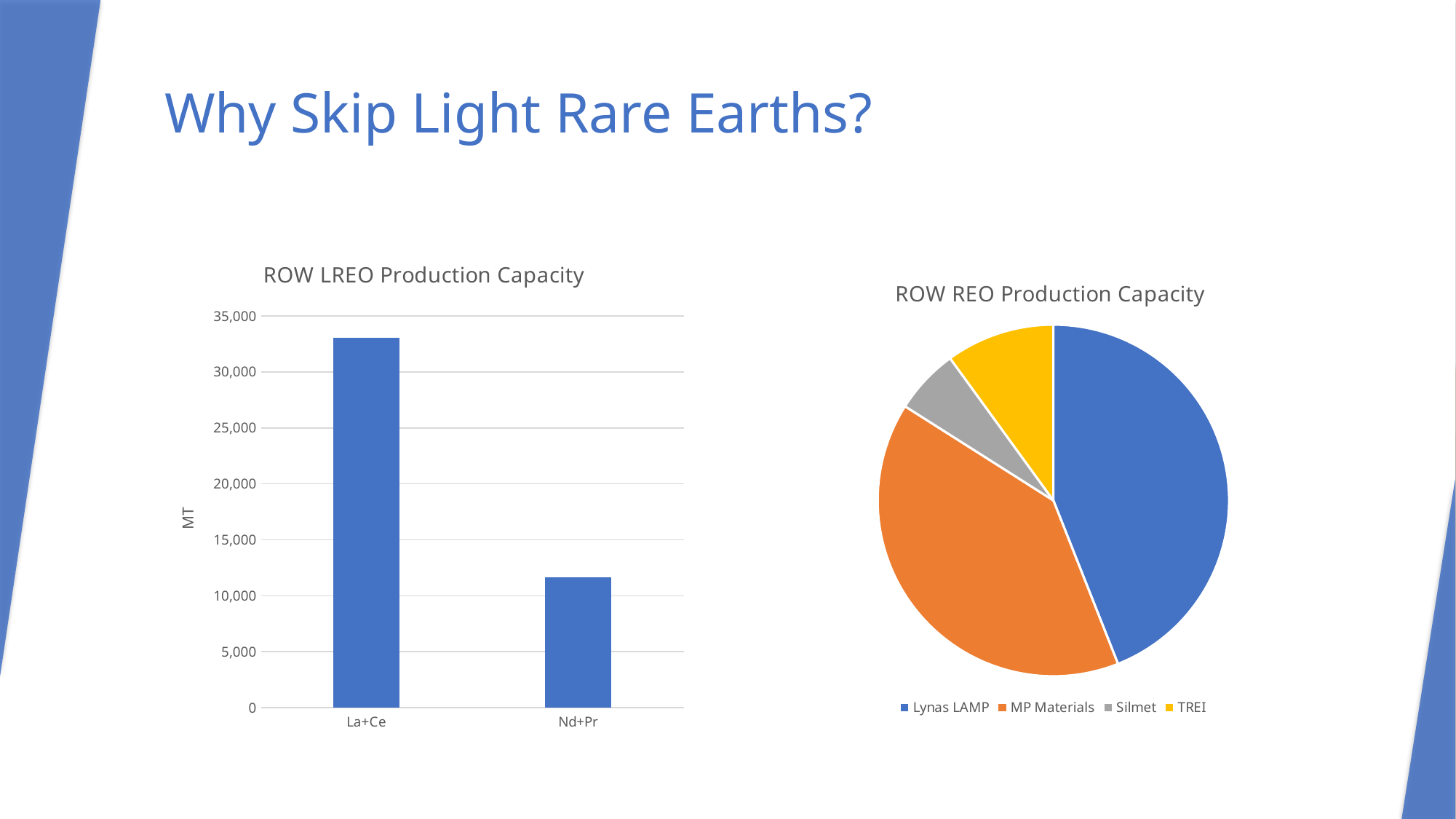
In the ROW LREO Production Capacity chart, is the value for Nd+Pr greater or less than 15,000? less What kind of chart is the ROW LREO Production Capacity chart? bar chart In the ROW LREO Production Capacity chart, which is larger, La+Ce or Nd+Pr? La+Ce In the ROW REO Production Capacity pie chart, which company has the smallest slice? Silmet What kind of chart is the ROW REO Production Capacity chart? pie chart In the ROW LREO Production Capacity chart, how many categories are shown on the x axis? 2 In the ROW LREO Production Capacity chart, what is the label on the vertical axis? MT How many entries does the legend of the ROW REO Production Capacity pie chart list? 4 In the ROW REO Production Capacity pie chart, which company has the largest slice? Lynas LAMP In the ROW LREO Production Capacity chart, which category has the highest value? La+Ce In the ROW LREO Production Capacity chart, is the value for La+Ce greater or less than 30,000? greater In the ROW LREO Production Capacity chart, which category has the lowest value? Nd+Pr